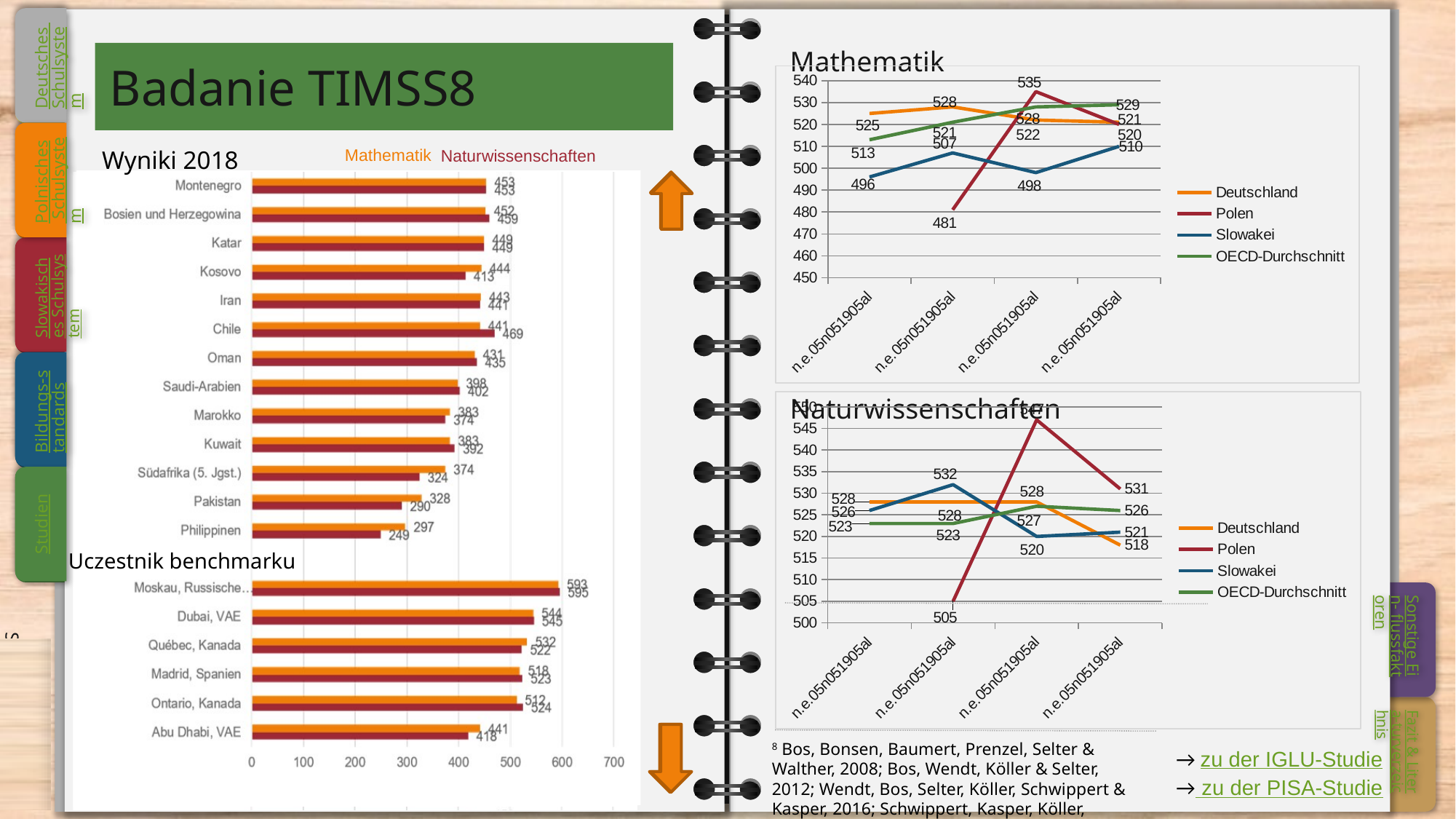
How many series does the legend of the left bar chart (Wyniki 2018) list? 2 How many series does the legend of the Mathematik line chart list? 4 In the Mathematik line chart, does the OECD-Durchschnitt line rise or fall from the first to the last point? rise In the left bar chart (Wyniki 2018), which is larger for Kosovo: the Mathematik value or the Naturwissenschaften value? Mathematik In the left bar chart (Wyniki 2018), what is the Naturwissenschaften value for Chile? 469 In the left bar chart (Wyniki 2018), what is the difference between the Mathematik and Naturwissenschaften values for Südafrika (5. Jgst.)? 50 In the left bar chart (Wyniki 2018), what is the Mathematik value for Montenegro? 453 In the Mathematik line chart, what is the value of Slowakei at the first point on the x axis? 496 What kind of chart is the left chart (Wyniki 2018)? bar chart In the left bar chart (Wyniki 2018), which category has the lowest Mathematik value? Philippinen In the Mathematik line chart, what is the highest value shown for Polen? 535 In the Naturwissenschaften line chart, what is the value of Deutschland at the last point on the x axis? 518